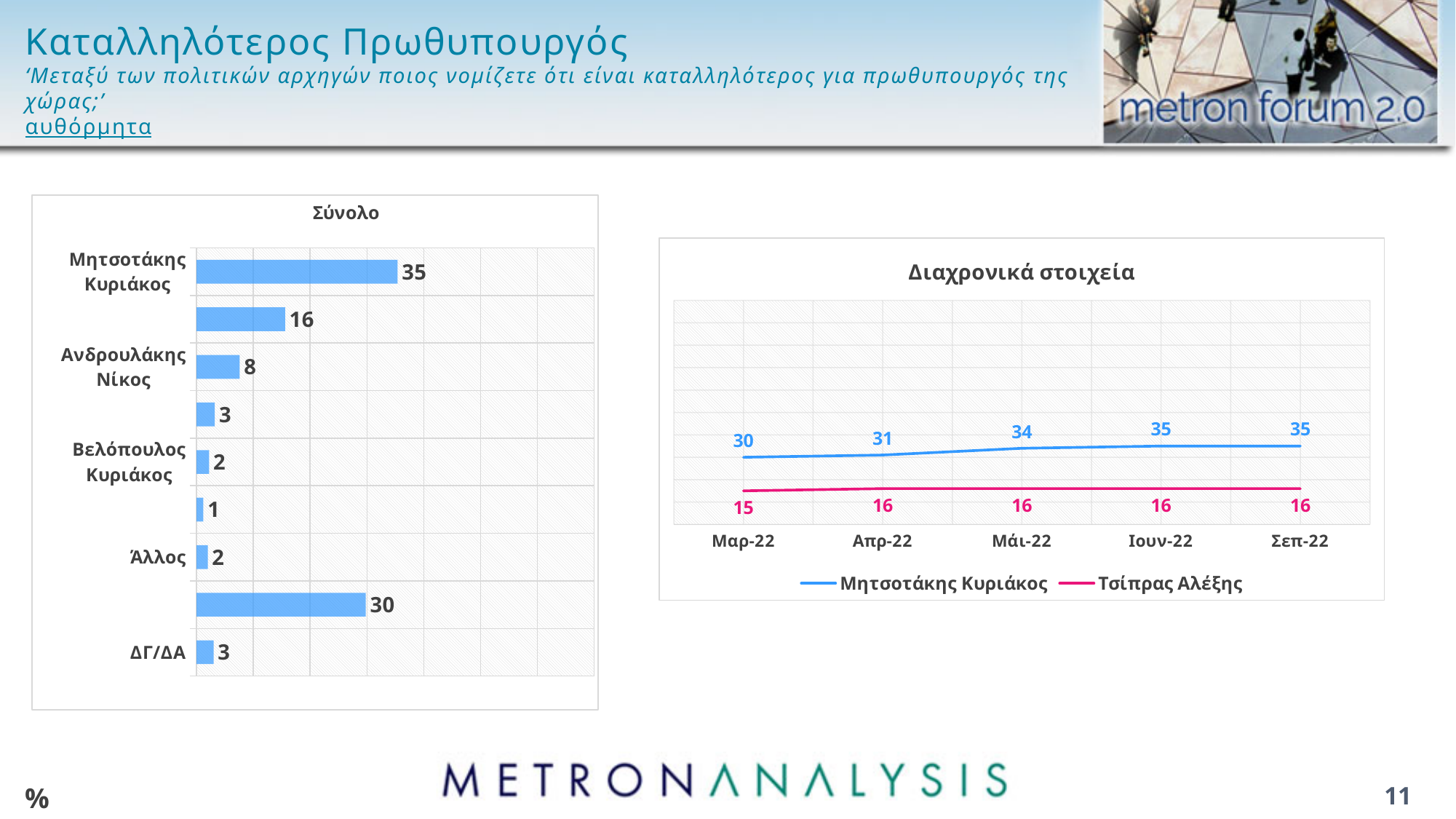
In the 'Σύνολο' bar chart, what is the value for ΔΓ/ΔΑ? 3 In the 'Σύνολο' bar chart, what is the difference between the values for Μητσοτάκης Κυριάκος and Ανδρουλάκης Νίκος? 27 In the 'Σύνολο' bar chart, what is the value for Ανδρουλάκης Νίκος? 8 What kind of chart is the 'Σύνολο' chart on the left? bar chart In the 'Σύνολο' bar chart, what is the value for Μητσοτάκης Κυριάκος? 35 In the 'Διαχρονικά στοιχεία' chart, what is the value for Τσίπρας Αλέξης in Μαρ-22? 15 How many series does the legend of the 'Διαχρονικά στοιχεία' chart list? 2 How many bars are plotted in the 'Σύνολο' chart? 9 In the 'Διαχρονικά στοιχεία' chart, what is the difference between Μητσοτάκης Κυριάκος and Τσίπρας Αλέξης in Σεπ-22? 19 What kind of chart is the 'Διαχρονικά στοιχεία' chart on the right? line chart In the 'Διαχρονικά στοιχεία' chart, does the line for Μητσοτάκης Κυριάκος rise or fall from Μαρ-22 to Σεπ-22? rise In the 'Διαχρονικά στοιχεία' chart, what is the value for Μητσοτάκης Κυριάκος in Μάι-22? 34